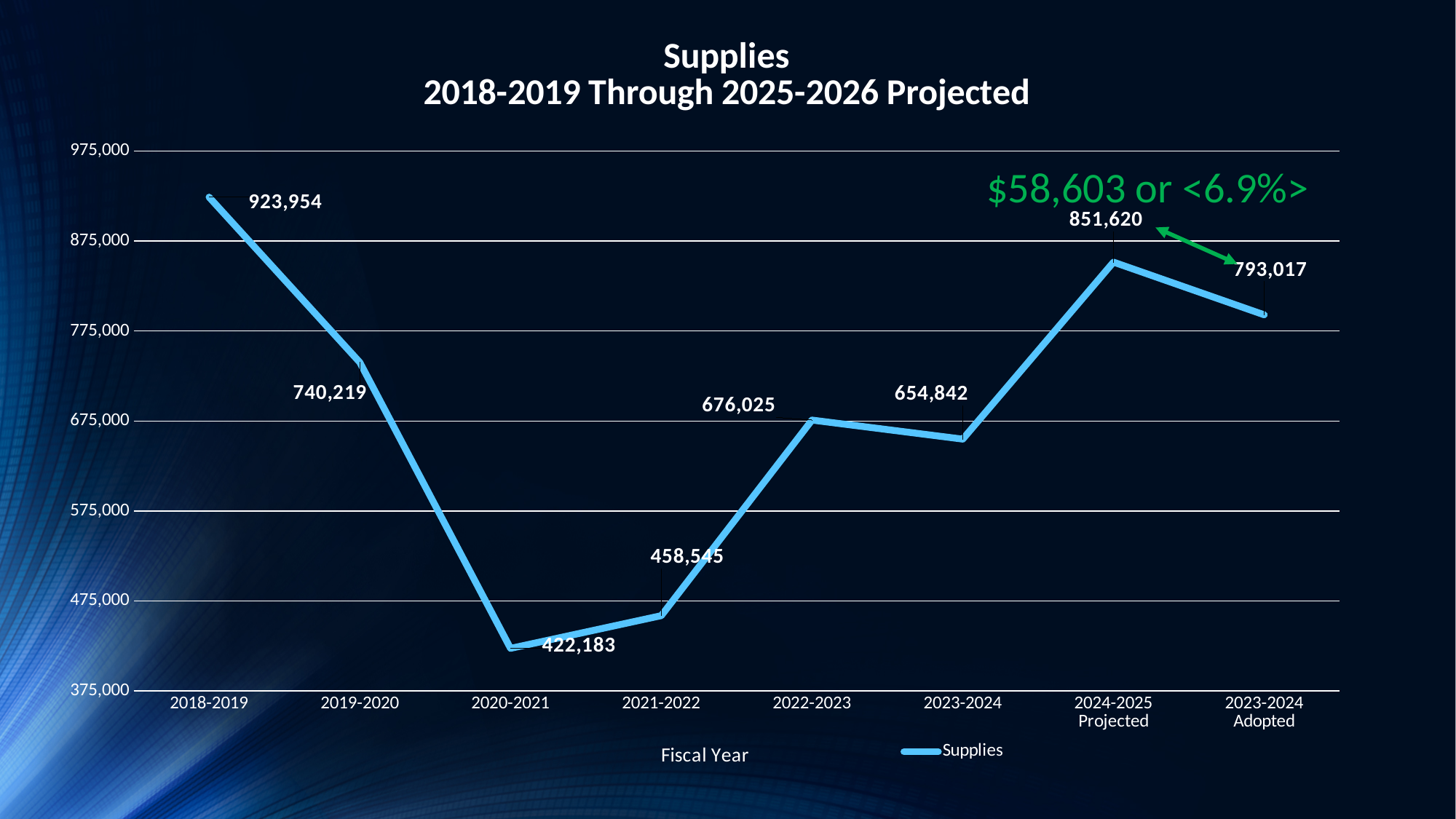
What is the difference between the Supplies values for 2018-2019 and 2019-2020? 183,735 What is the difference between the Supplies values for 2024-2025 Projected and 2023-2024 Adopted? 58,603 What is the Supplies value for 2024-2025 Projected? 851,620 What kind of chart is shown on the slide? Line chart Which fiscal year has the highest Supplies value? 2018-2019 Does the Supplies value rise or fall from 2019-2020 to 2020-2021? Fall What is the Supplies value for 2020-2021? 422,183 What is the Supplies value for the last point, labelled 2023-2024 Adopted? 793,017 What is the Supplies value for 2018-2019? 923,954 How many fiscal year points are plotted on the chart? 8 Which fiscal year has the lowest Supplies value? 2020-2021 Which is larger, the Supplies value for 2022-2023 or for 2023-2024? 2022-2023